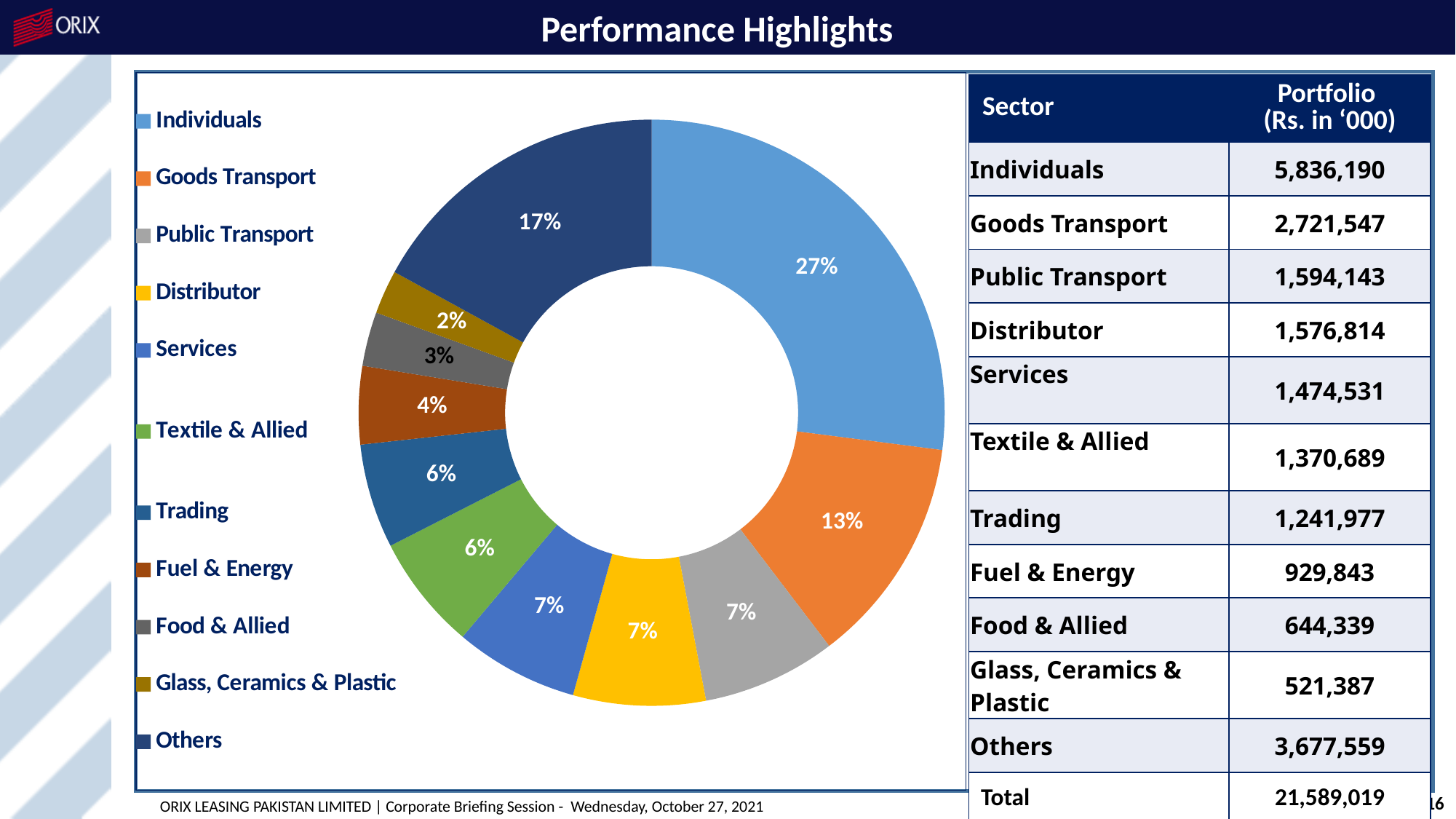
Which has a larger share, Goods Transport or Trading? Goods Transport Which sector has the smallest share in the doughnut chart? Glass, Ceramics & Plastic What percentage is shown for the Glass, Ceramics & Plastic slice? 2% What type of chart is shown on the slide? Doughnut chart What percentage is shown for the Fuel & Energy slice? 4% What percentage share does the Individuals slice have in the doughnut chart? 27% What percentage is shown for the Others slice? 17% Which sector has the largest share in the doughnut chart? Individuals What is the difference in percentage points between the Individuals slice and the Others slice? 10 How many sectors are listed in the chart legend? 11 What colour is the Distributor slice in the chart? Yellow What percentage is shown for the Goods Transport slice? 13%